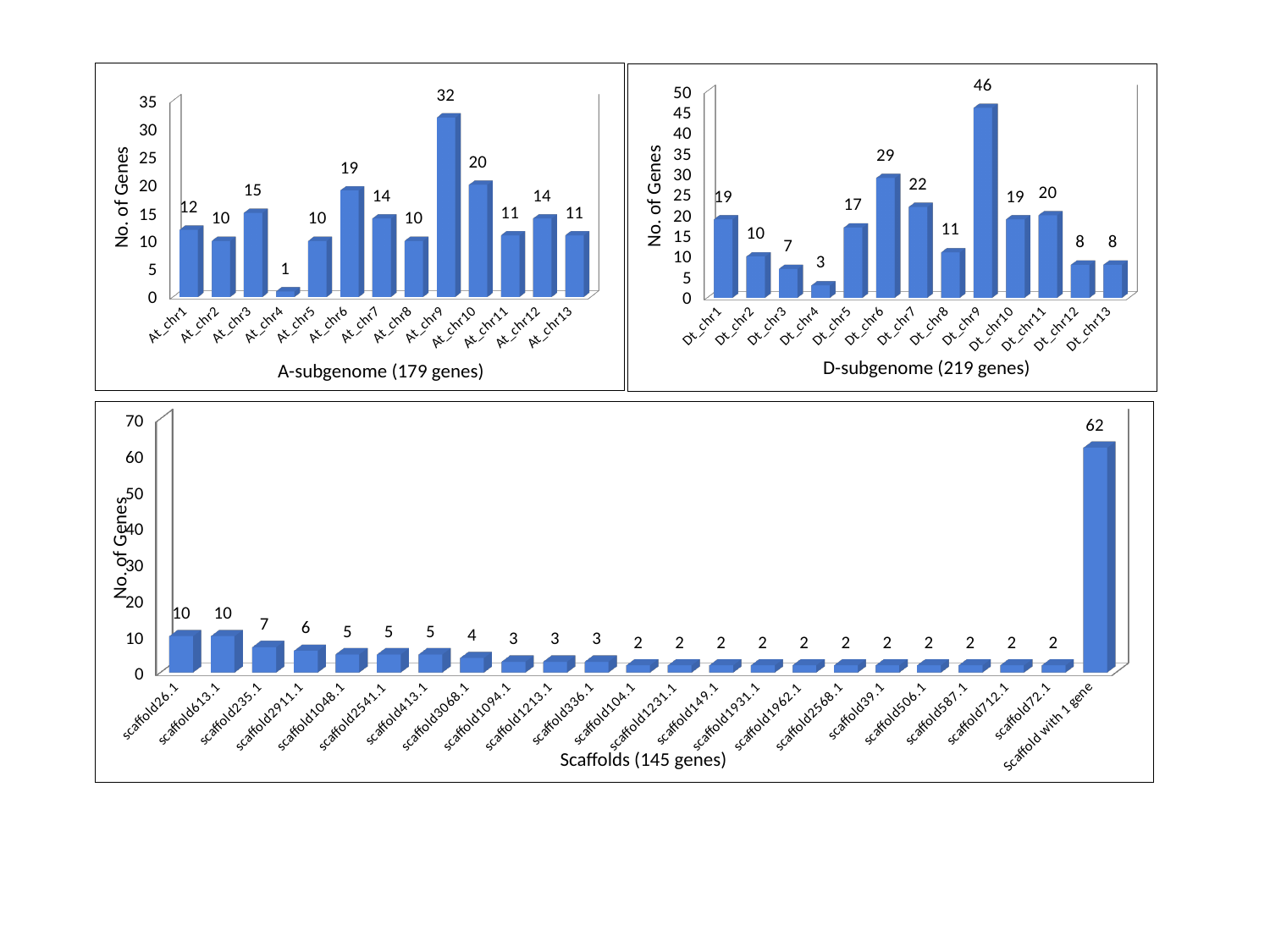
In the A-subgenome chart, what is the difference in number of genes between At_chr10 and At_chr6? 1 What type of chart is the Scaffolds chart? Bar chart In the Scaffolds chart, how many genes are in the 'Scaffold with 1 gene' category? 62 In the D-subgenome chart, how many genes are on Dt_chr6? 29 In the A-subgenome chart, which chromosome has the fewest genes? At_chr4 What is the y-axis label of the A-subgenome chart? No. of Genes In the Scaffolds chart, how many categories are shown on the x axis? 23 In the D-subgenome chart, which has more genes, Dt_chr7 or Dt_chr11? Dt_chr7 In the A-subgenome chart, how many genes are on At_chr9? 32 In the Scaffolds chart, how many genes does scaffold235.1 have? 7 In the D-subgenome chart, which chromosome has the most genes? Dt_chr9 In the D-subgenome chart, how many chromosomes are plotted? 13